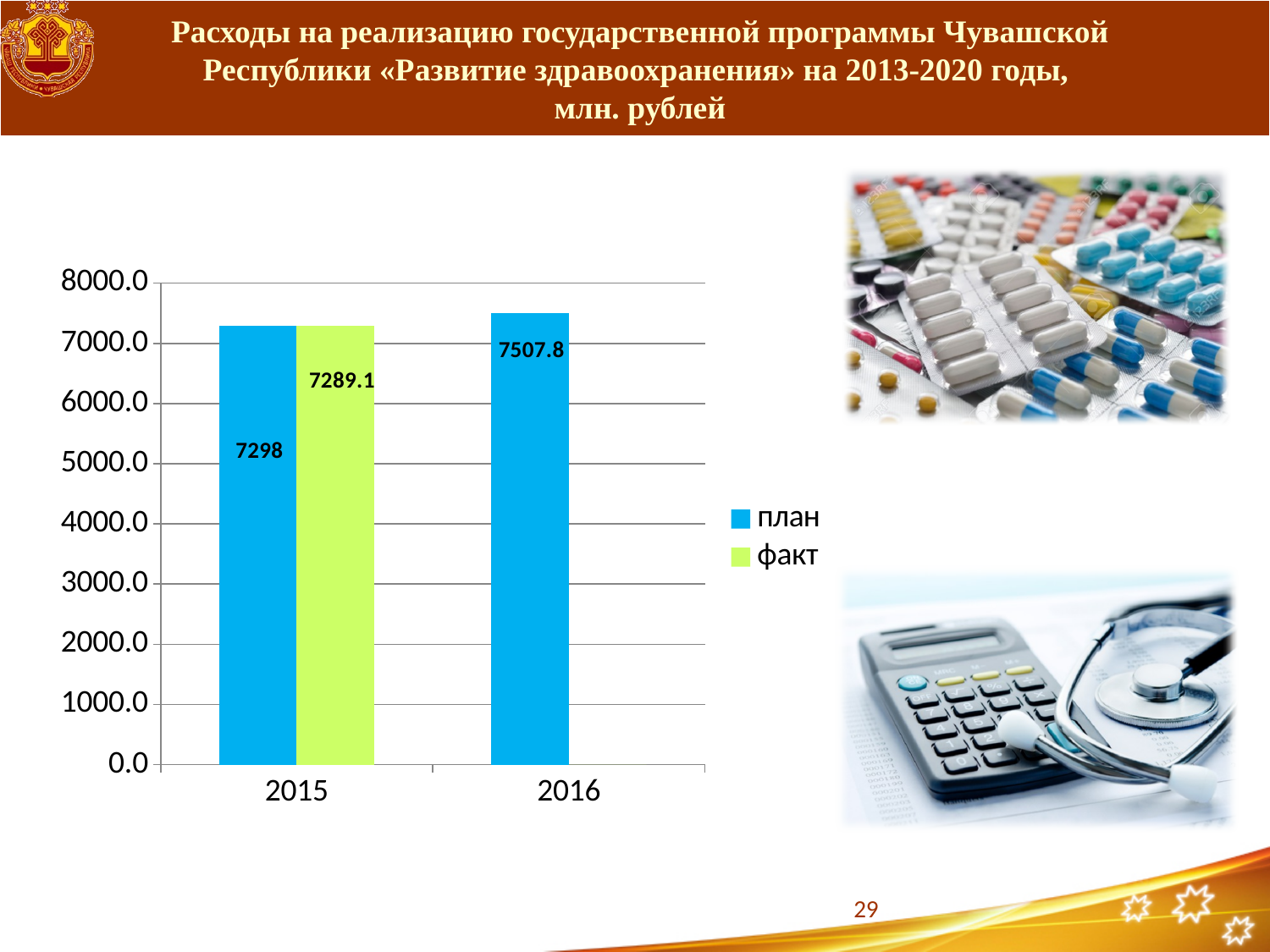
What is the value of the план bar for 2015? 7298 What is the difference between the план value for 2016 and the план value for 2015? 209.8 Which is larger: the план value for 2016 or the план value for 2015? план for 2016 Does the план value rise or fall from 2015 to 2016? rise Which bar on the chart has the highest value? план for 2016 (7507.8) What is the difference between the план and факт values for 2015? 8.9 Is the план value for 2016 greater or less than 7000.0? greater What kind of chart is shown on the slide? bar chart How many series does the legend list? 2 How many years are shown on the x axis of the chart? 2 What is the value of the план bar for 2016? 7507.8 What is the value of the факт bar for 2015? 7289.1